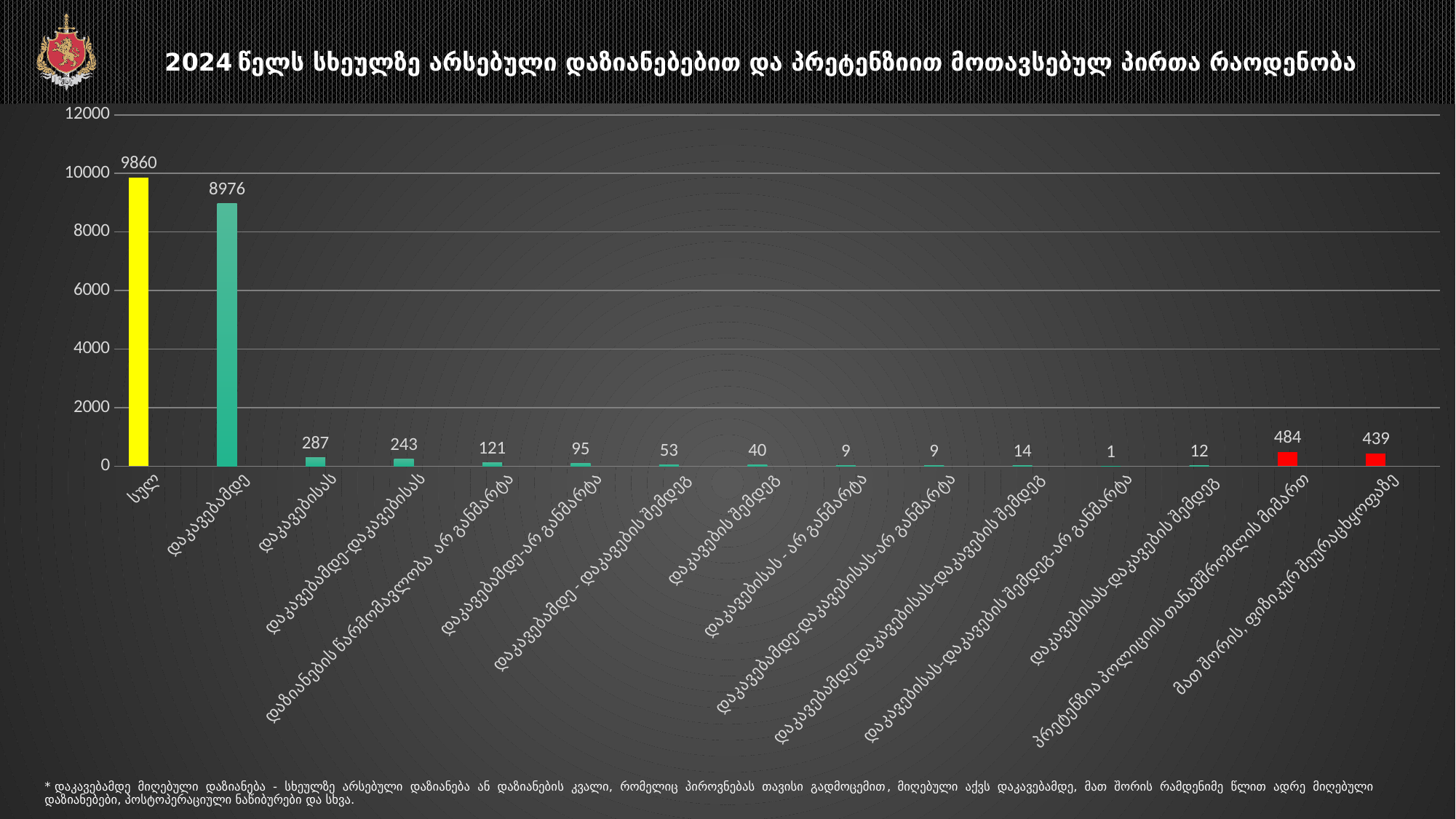
Which category has the lowest value? დაკავებისას-დაკავების შემდეგ-არ განმარტა Which category has the highest value? სულ What is the value for სულ? 9860 What is the difference between the values for სულ and დაკავებამდე? 884 What is the value for დაკავებამდე? 8976 What is the difference between the values for პრეტენზია პოლიციის თანამშრომლის მიმართ and მათ შორის, ფიზიკურ შეურაცხყოფაზე? 45 What type of chart is shown on the slide? bar chart How many categories are plotted on the chart? 15 What colour is the bar for სულ? yellow What is the value for პრეტენზია პოლიციის თანამშრომლის მიმართ? 484 What is the value for დაკავების შემდეგ? 40 Which is larger, the value for დაზიანების წარმომავლობა არ განმარტა or the value for დაკავებამდე-არ განმარტა? დაზიანების წარმომავლობა არ განმარტა